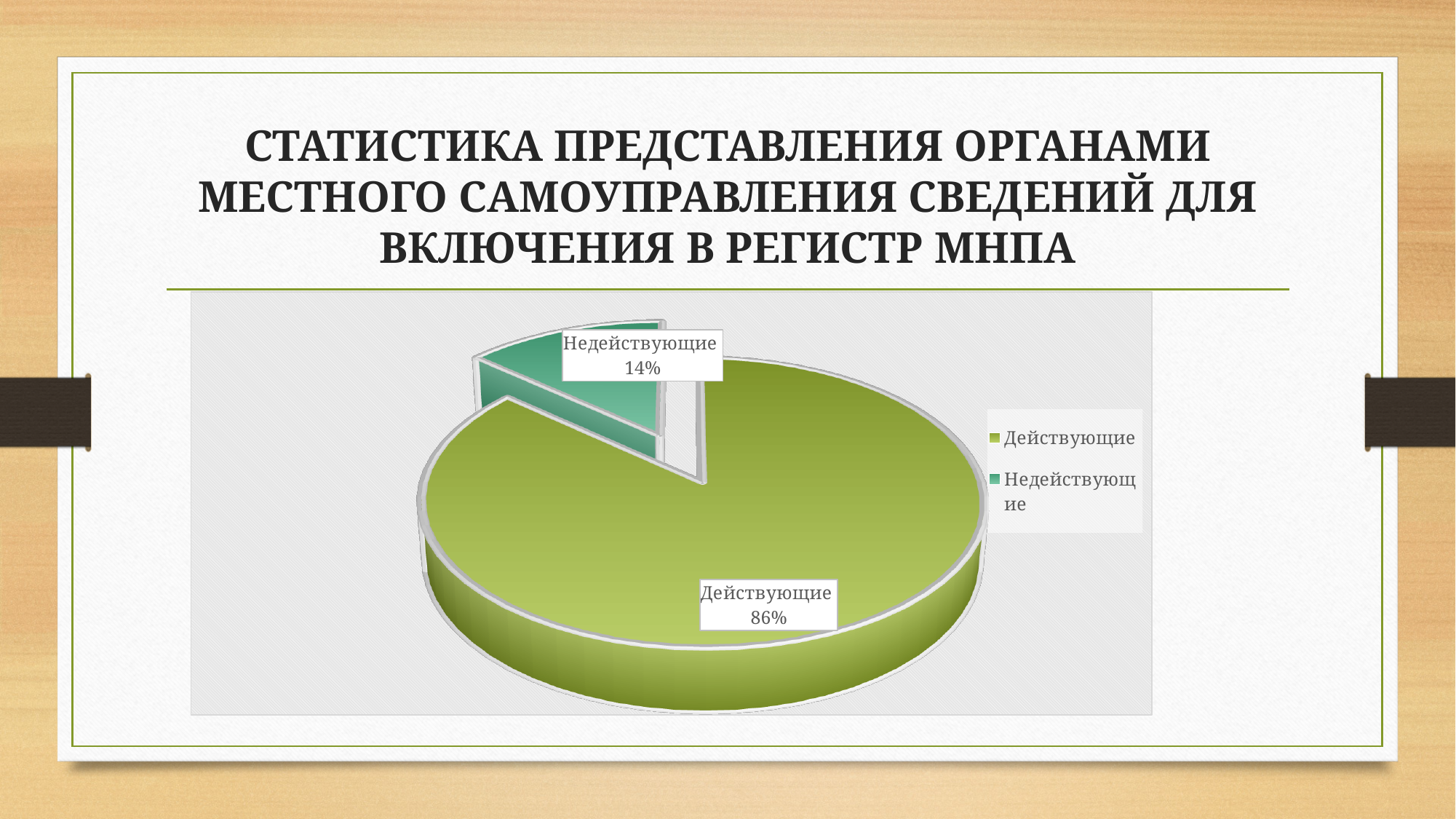
Which is larger, Действующие or Недействующие? Действующие What share of the pie does Недействующие represent? 14% What share of the pie does Действующие represent? 86% What colour is the Действующие slice? green Which slice is pulled out (exploded) from the pie? Недействующие What is the total of the two slice percentages shown? 100% What kind of chart is shown on the slide? pie chart How many entries does the legend list? 2 Which slice is the largest? Действующие What is the difference in percentage points between Действующие and Недействующие? 72 How many slices does the pie chart have? 2 Which slice is the smallest? Недействующие